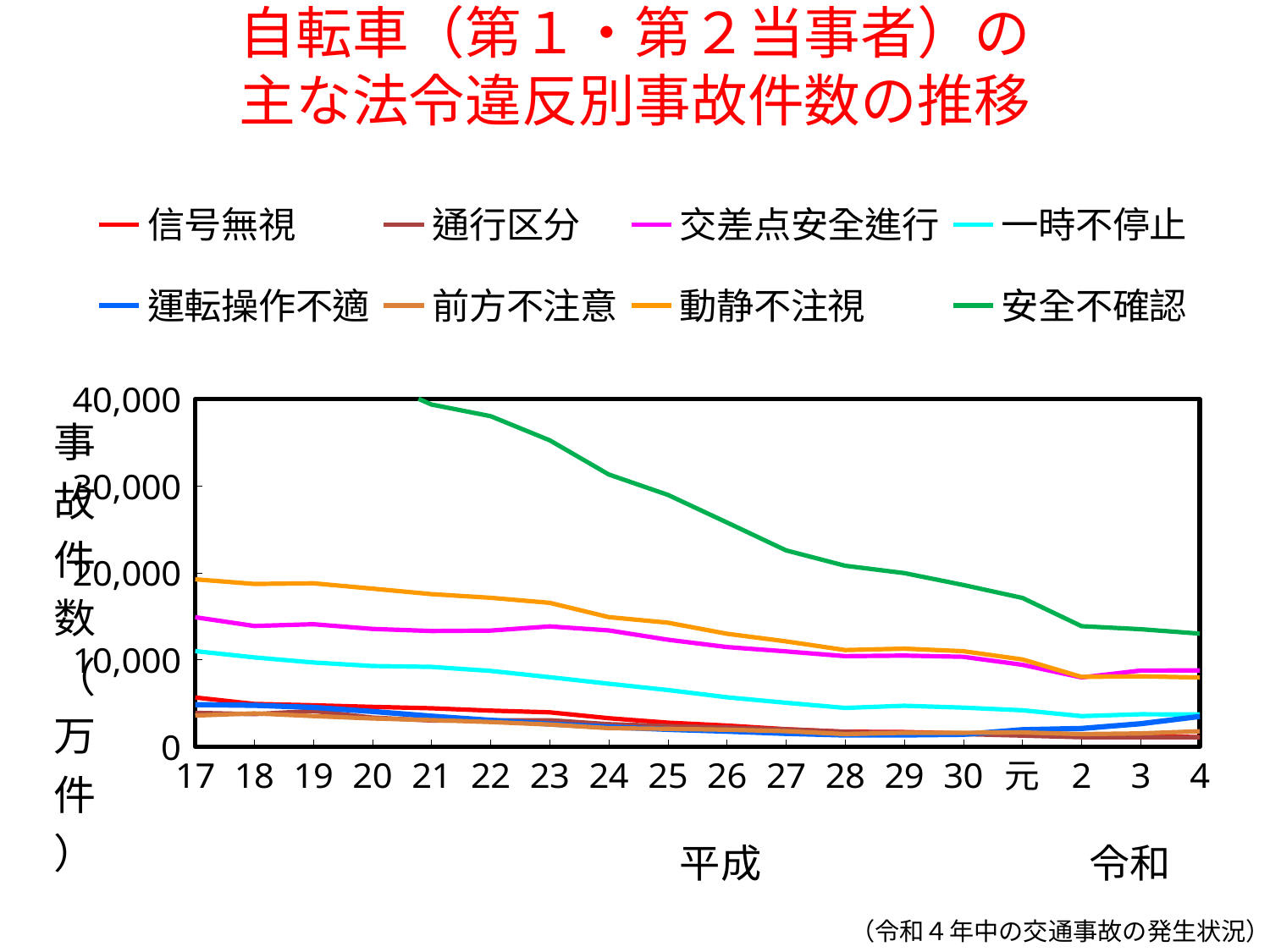
Is the value for 安全不確認 in 平成27 greater or less than 20,000? greater Does the 安全不確認 line rise or fall from 平成21 to 令和4? fall What colour is the 安全不確認 line in the legend? green Is the value for 一時不停止 in 令和4 greater or less than 10,000? less Is the value for 安全不確認 in 令和4 greater or less than 10,000? greater In 平成25, which is larger: 交差点安全進行 or 一時不停止? 交差点安全進行 How many year points are shown along the x axis? 18 How many series does the legend list? 8 What kind of chart is shown on the slide? line chart Which series has the highest value in 令和4? 安全不確認